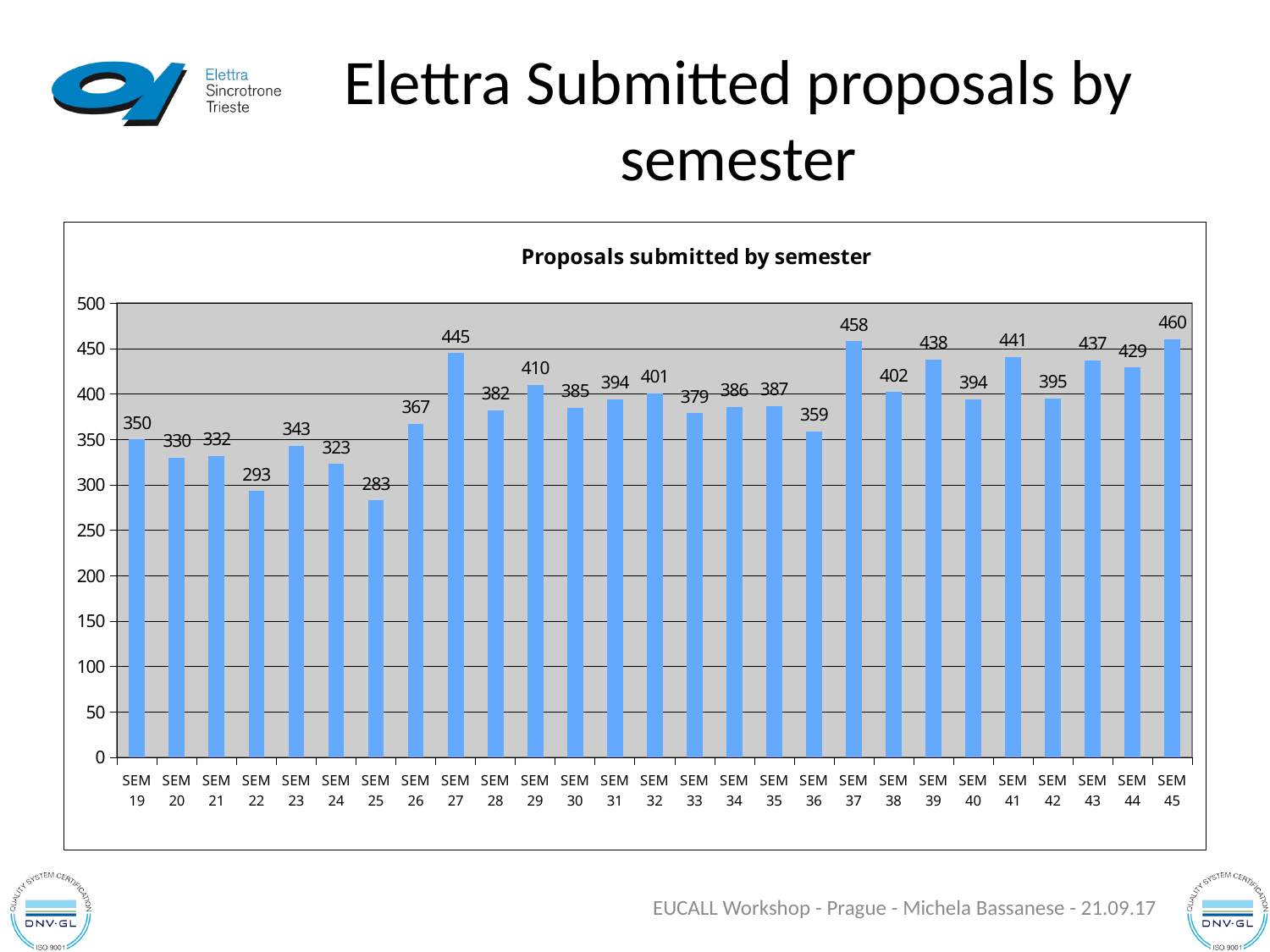
What is the title of the chart? Proposals submitted by semester What is the value shown for SEM 22? 293 Which has more submitted proposals, SEM 29 or SEM 33? SEM 29 How many proposals were submitted in SEM 27? 445 Is the value for SEM 26 greater or less than 350? greater How many proposals were submitted in SEM 37? 458 How many semesters are shown on the x axis? 27 Which semester has the lowest number of submitted proposals? SEM 25 What is the difference between the values for SEM 45 and SEM 25? 177 What kind of chart is shown on the slide? Bar chart What is the difference between the values for SEM 37 and SEM 36? 99 Which semester has the highest number of submitted proposals? SEM 45